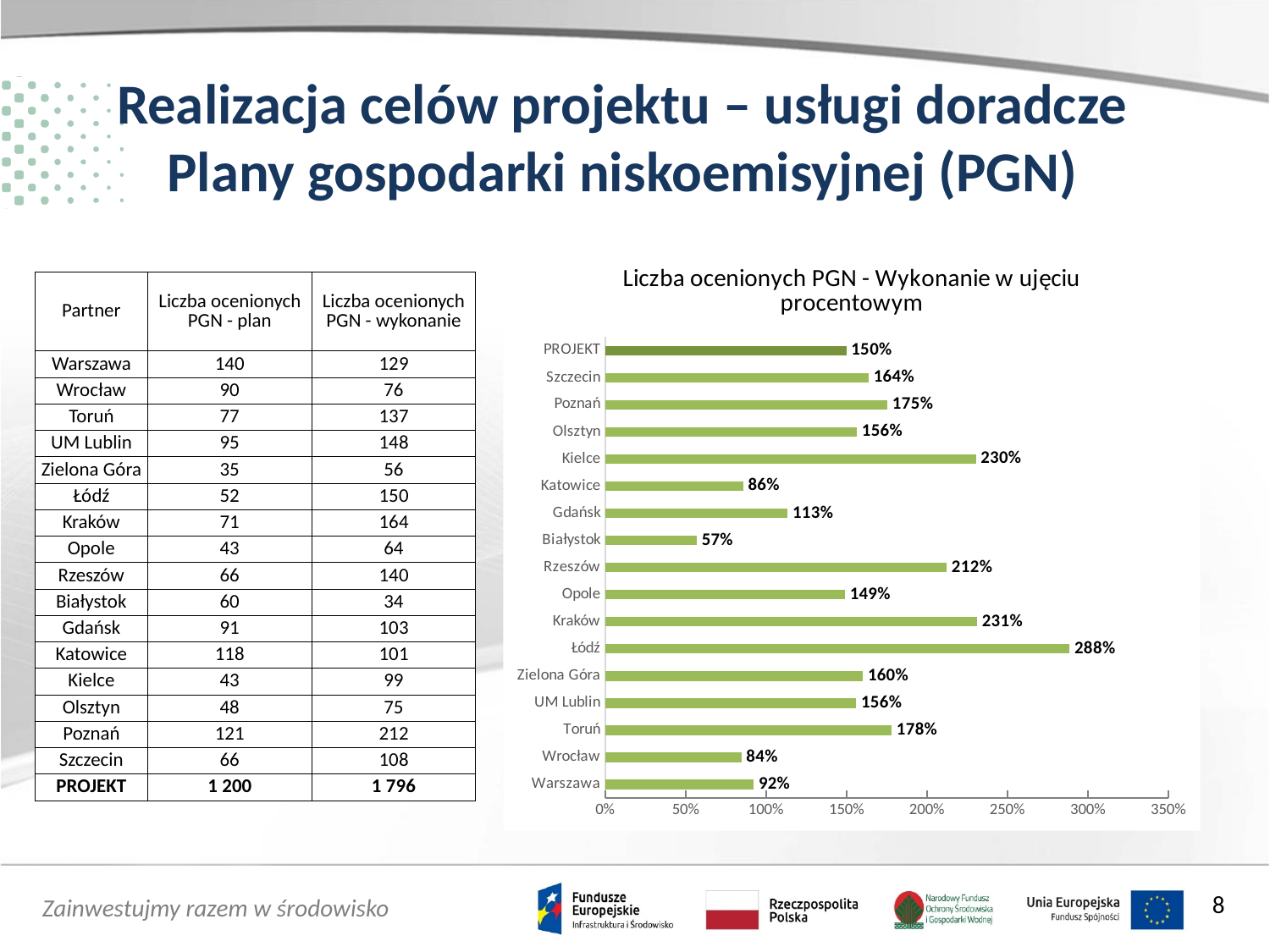
What is the title of the chart? Liczba ocenionych PGN - Wykonanie w ujęciu procentowym What is the maximum value shown on the chart's horizontal axis? 350% What kind of chart is shown on the slide? bar chart Which has a larger value in the chart, Rzeszów or Toruń? Rzeszów What is the value shown for Katowice in the chart? 86% Which category has the lowest value in the chart? Białystok What is the value shown for Łódź in the chart? 288% What is the value shown for PROJEKT in the chart? 150% Is the value for Warszawa in the chart greater or less than 100%? less How many categories are shown in the chart? 17 What is the difference between the values for Poznań and Szczecin in the chart? 11 percentage points Which category has the highest value in the chart? Łódź